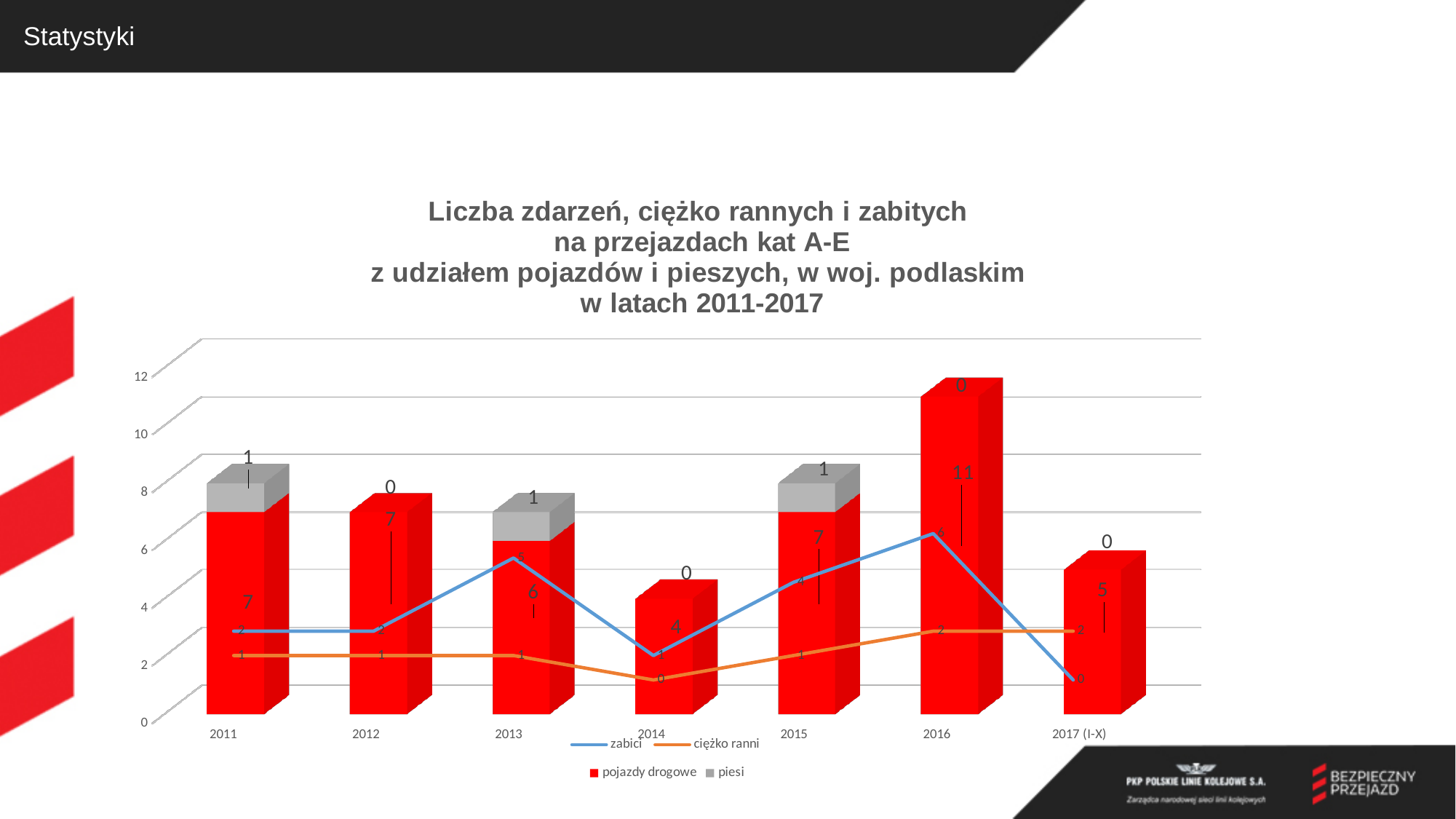
In which year is the value for pojazdy drogowe highest? 2016 What is the difference between the pojazdy drogowe values for 2016 and 2017 (I-X)? 6 Which series is drawn as an orange line? ciężko ranni How many series does the legend list? 4 In which year is the value for pojazdy drogowe lowest? 2014 What is the value for piesi in 2013? 1 Which is larger, the zabici value for 2013 or for 2014? 2013 What is the value for pojazdy drogowe in 2016? 11 What is the value for ciężko ranni in 2017 (I-X)? 2 How many years are shown on the x axis? 7 What is the value for zabici in 2015? 4 What is the total of the stacked bar for 2011 (pojazdy drogowe plus piesi)? 8